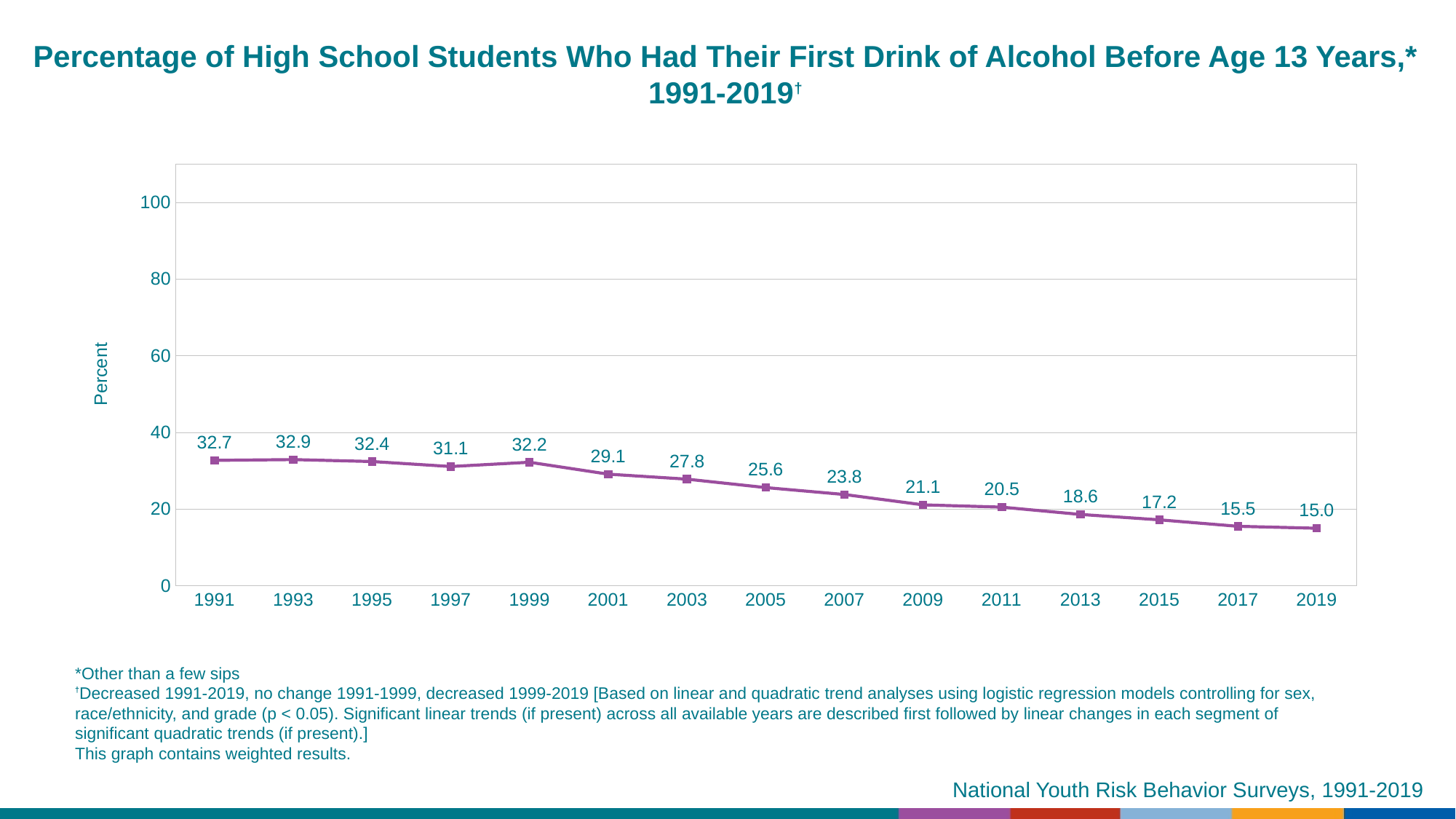
What is the value for 2019? 15.0 How many years are plotted on the chart? 15 What is the difference between the values for 1991 and 2019? 17.7 What is the label on the y axis? Percent Which year has the highest value? 1993 Which is larger, the value for 1997 or the value for 1999? 1999 What is the value for 1991? 32.7 Is the value for 2009 greater or less than 20? greater Which year has the lowest value? 2019 What kind of chart is shown? line chart What is the value for 2005? 25.6 Do the values generally rise or fall from 1999 to 2019? fall